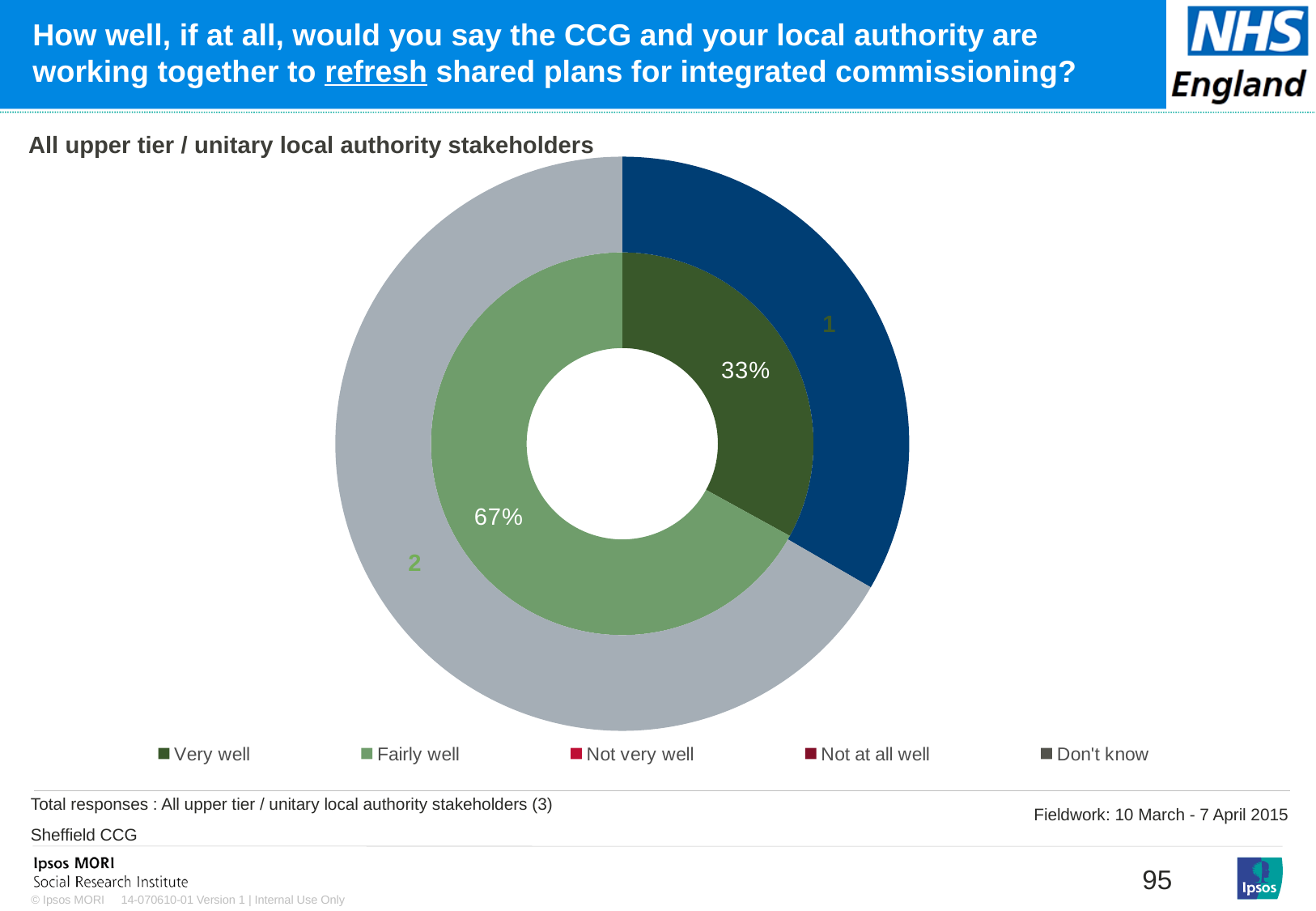
What is the total number of responses shown for all upper tier / unitary local authority stakeholders? 3 Which CCG is this chart about? Sheffield CCG What is the difference in percentage points between 'Fairly well' and 'Very well'? 34 What is the combined percentage of 'Very well' and 'Fairly well' responses? 100% Which is larger, the share for 'Very well' or the share for 'Fairly well'? Fairly well What kind of chart is shown on the slide? Doughnut chart What number is shown on the outer ring segment corresponding to 'Fairly well'? 2 What number is shown on the outer ring segment corresponding to 'Very well'? 1 What percentage of respondents said 'Fairly well'? 67% What percentage of respondents said 'Very well'? 33% How many response categories does the legend list? 5 Which response category has the largest share in the chart? Fairly well